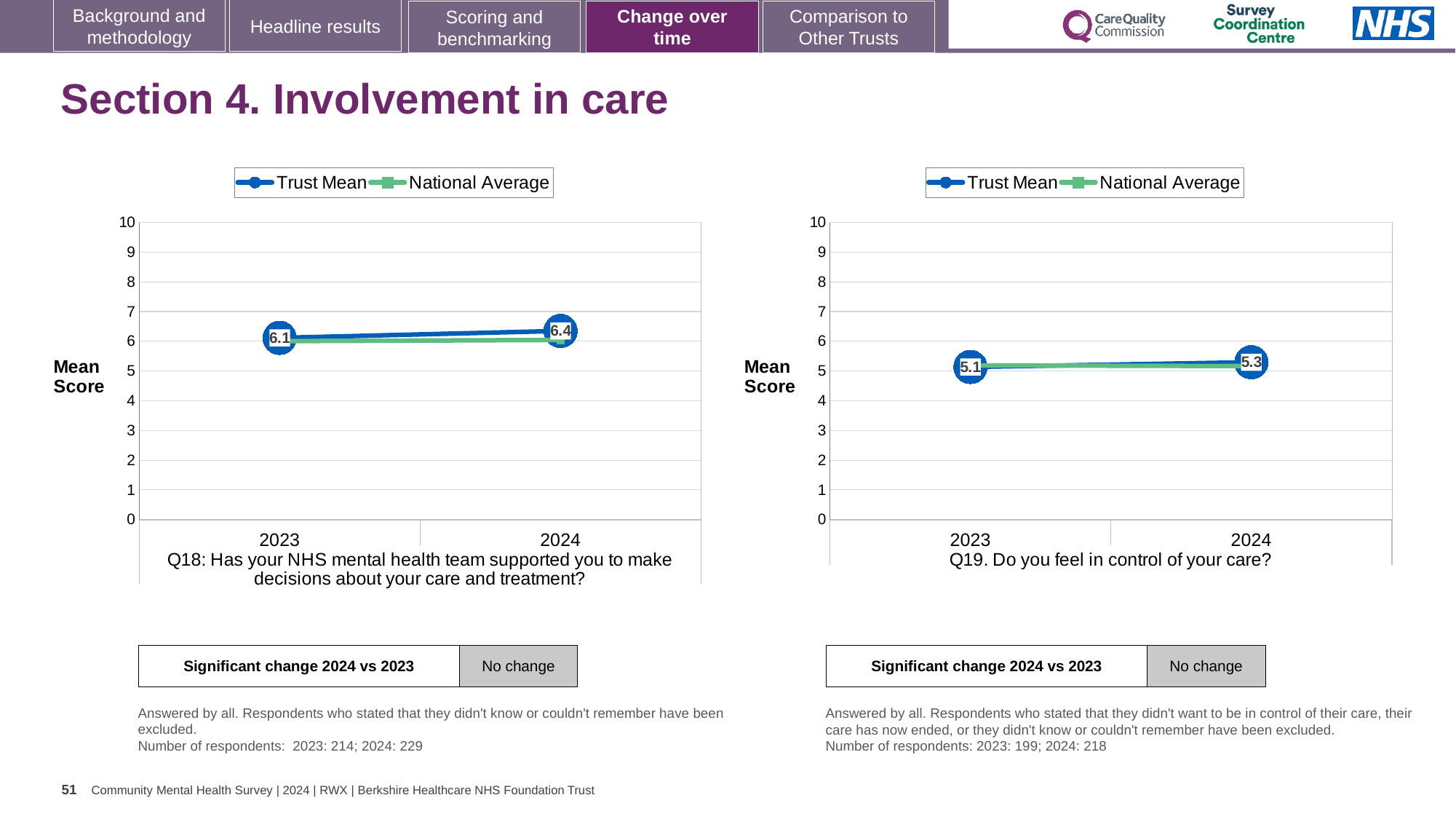
In the Q18 chart (left), what is the Trust Mean score for 2023? 6.1 How many series does the legend of the Q19 chart (right) list? 2 In the Q18 chart (left), does the Trust Mean rise or fall from 2023 to 2024? rise In the Q19 chart (right), what is the difference between the Trust Mean in 2024 and in 2023? 0.2 In the Q18 chart (left), by how much did the Trust Mean change from 2023 to 2024? 0.3 In the Q19 chart (right), what is the Trust Mean score for 2023? 5.1 In the Q18 chart (left), what is the Trust Mean score for 2024? 6.4 What kind of chart is the Q18 chart (left)? line chart In the Q19 chart (right), what is the Trust Mean score for 2024? 5.3 In the Q19 chart (right), is the Trust Mean for 2024 higher or lower than for 2023? higher How many years are shown on the x axis of the Q18 chart (left)? 2 In the Q19 chart (right), is the National Average for 2023 greater or less than 6? less